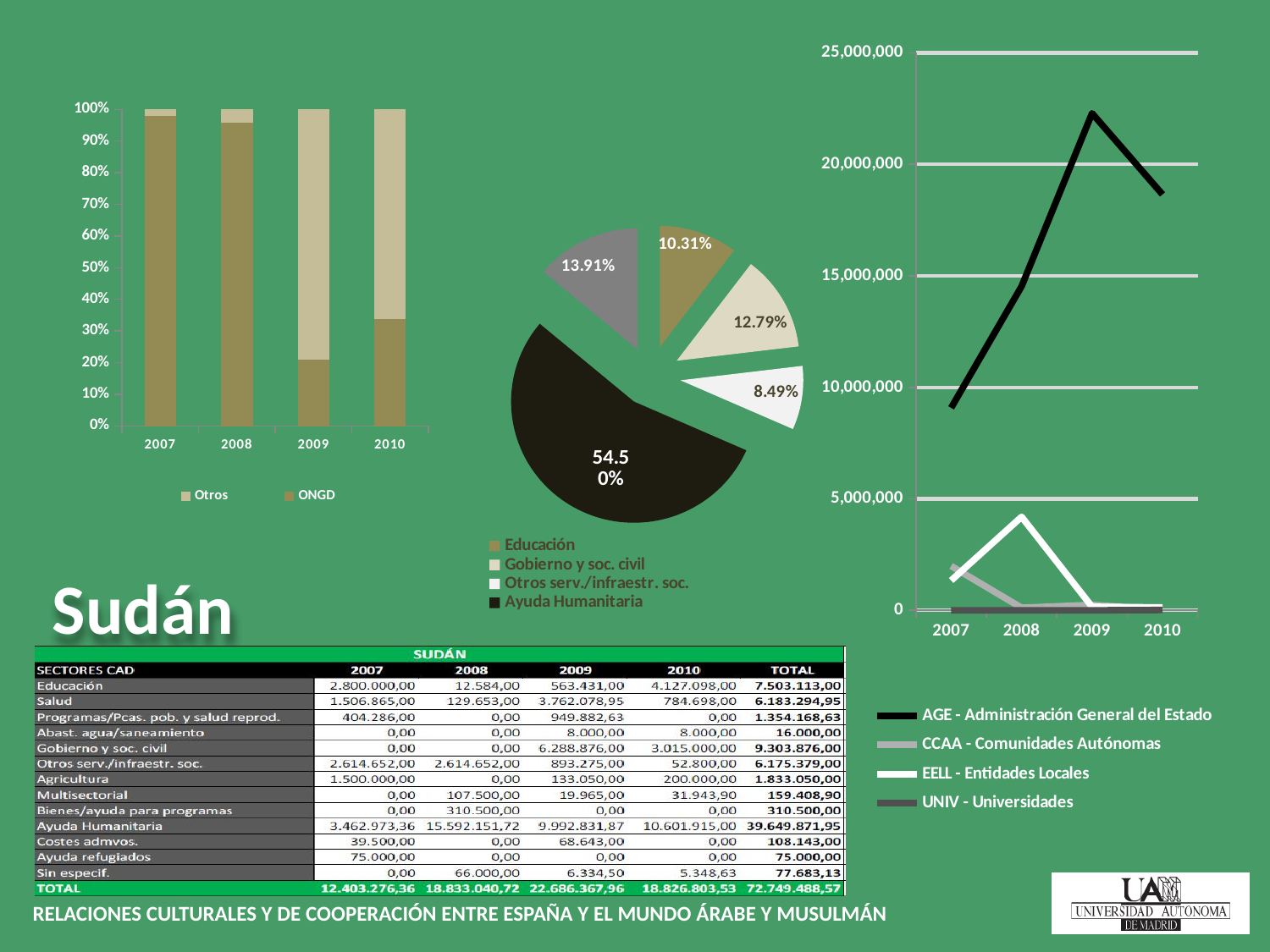
In the line chart on the right, is the AGE value for 2009 greater or less than 20,000,000? greater In the pie chart, what is the difference between the Gobierno y soc. civil share and the Educación share? 2.48% In the pie chart, which sector has the smallest slice? Otros serv./infraestr. soc. In the pie chart, how many sectors does the legend list? 4 In the pie chart, what percentage is shown for Gobierno y soc. civil? 12.79% In the pie chart, what percentage is shown for Educación? 10.31% In the pie chart, what percentage is shown for Ayuda Humanitaria? 54.50% In the pie chart, which sector has the largest slice? Ayuda Humanitaria What kind of chart is the chart on the left showing Otros and ONGD? Stacked bar chart In the line chart on the right, how many series does the legend list? 4 In the line chart on the right, in which year does the AGE series reach its highest value? 2009 In the stacked bar chart on the left, is the ONGD share for 2009 greater or less than 30%? less